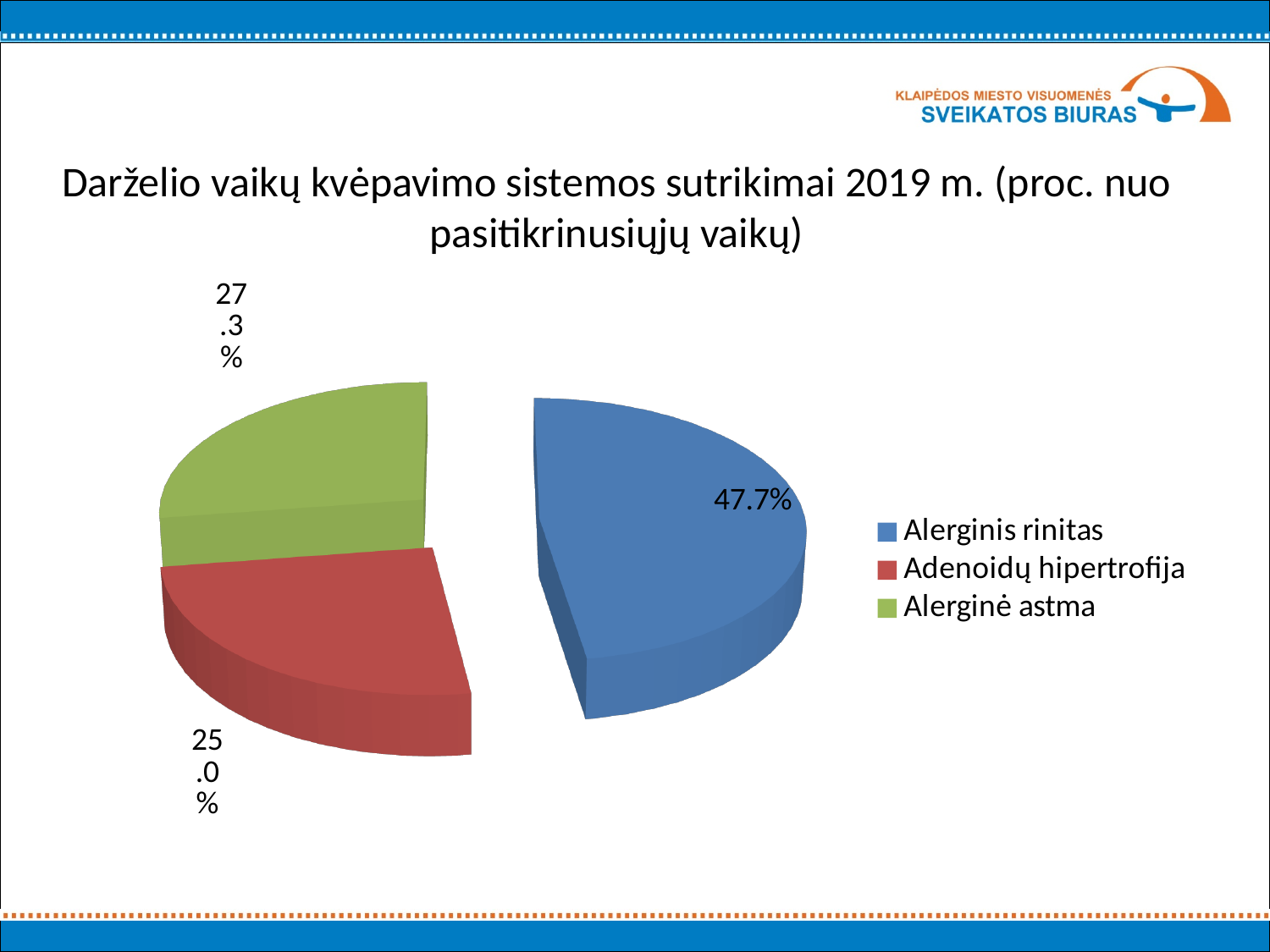
How many entries does the legend list? 3 What kind of chart is shown on the slide? pie chart What is the difference between the values for Alerginis rinitas and Alerginė astma? 20.4% How many slices does the pie chart have? 3 What is the value for Adenoidų hipertrofija? 25.0% What is the value for Alerginis rinitas? 47.7% Which category has the largest share of the pie? Alerginis rinitas Which category has the smallest share of the pie? Adenoidų hipertrofija What colour is the slice for Alerginė astma? green Which is larger, the value for Alerginė astma or the value for Adenoidų hipertrofija? Alerginė astma What is the value for Alerginė astma? 27.3% What is the difference between the values for Alerginė astma and Adenoidų hipertrofija? 2.3%